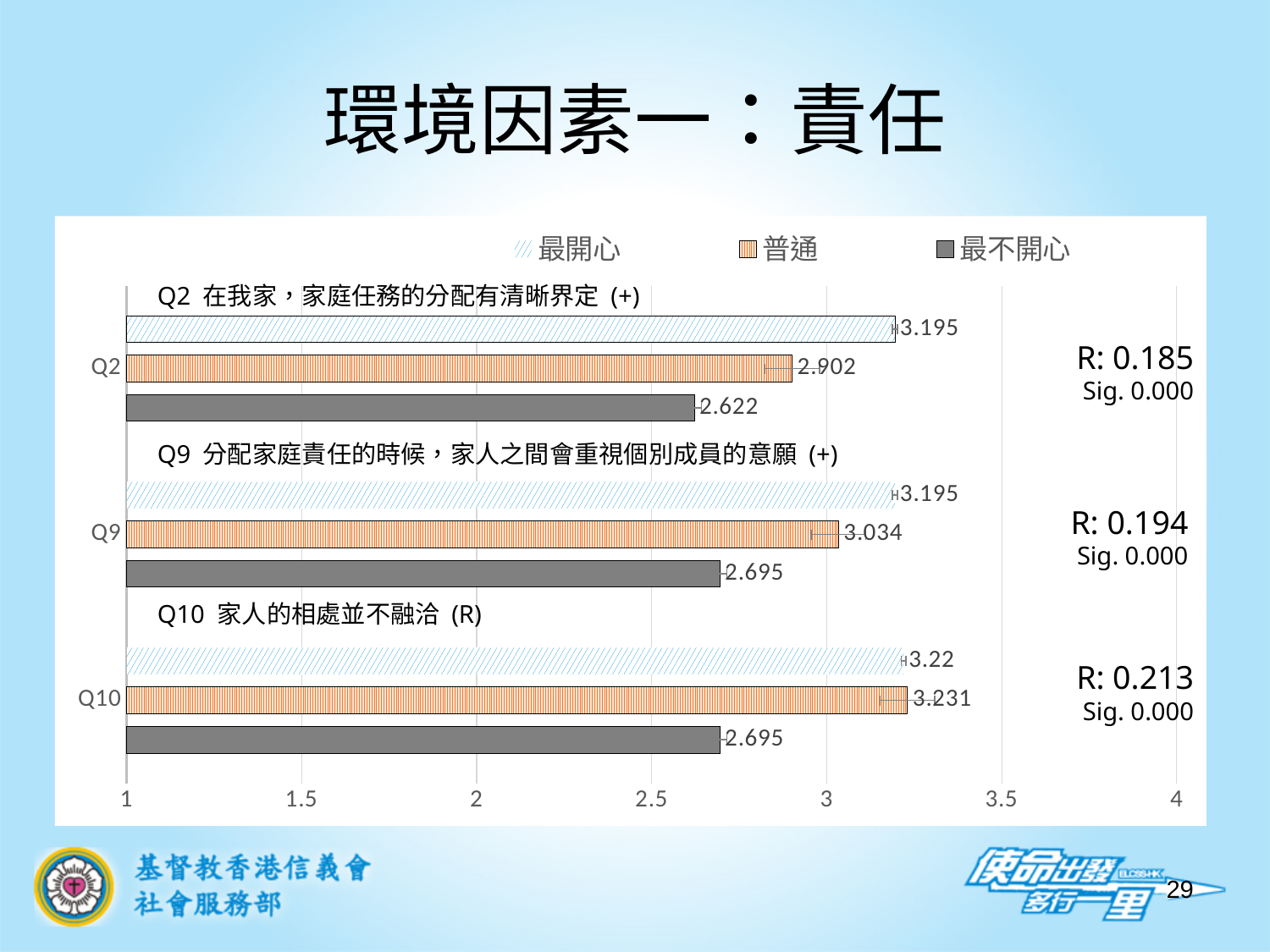
What is the value of 最開心 for Q2? 3.195 How many question categories (Q items) are plotted on the chart? 3 What is the difference between the 最開心 and 最不開心 values for Q2? 0.573 What is the value of 普通 for Q10? 3.231 Which category has the lowest 最不開心 value? Q2 What is the value of 普通 for Q9? 3.034 Which category has the highest 普通 value? Q10 Which is larger for Q9: the 普通 value or the 最不開心 value? 普通 What is the value of 最不開心 for Q10? 2.695 What R value is shown next to Q10? R: 0.213 What kind of chart is shown on the slide? bar chart How many series does the legend list? 3